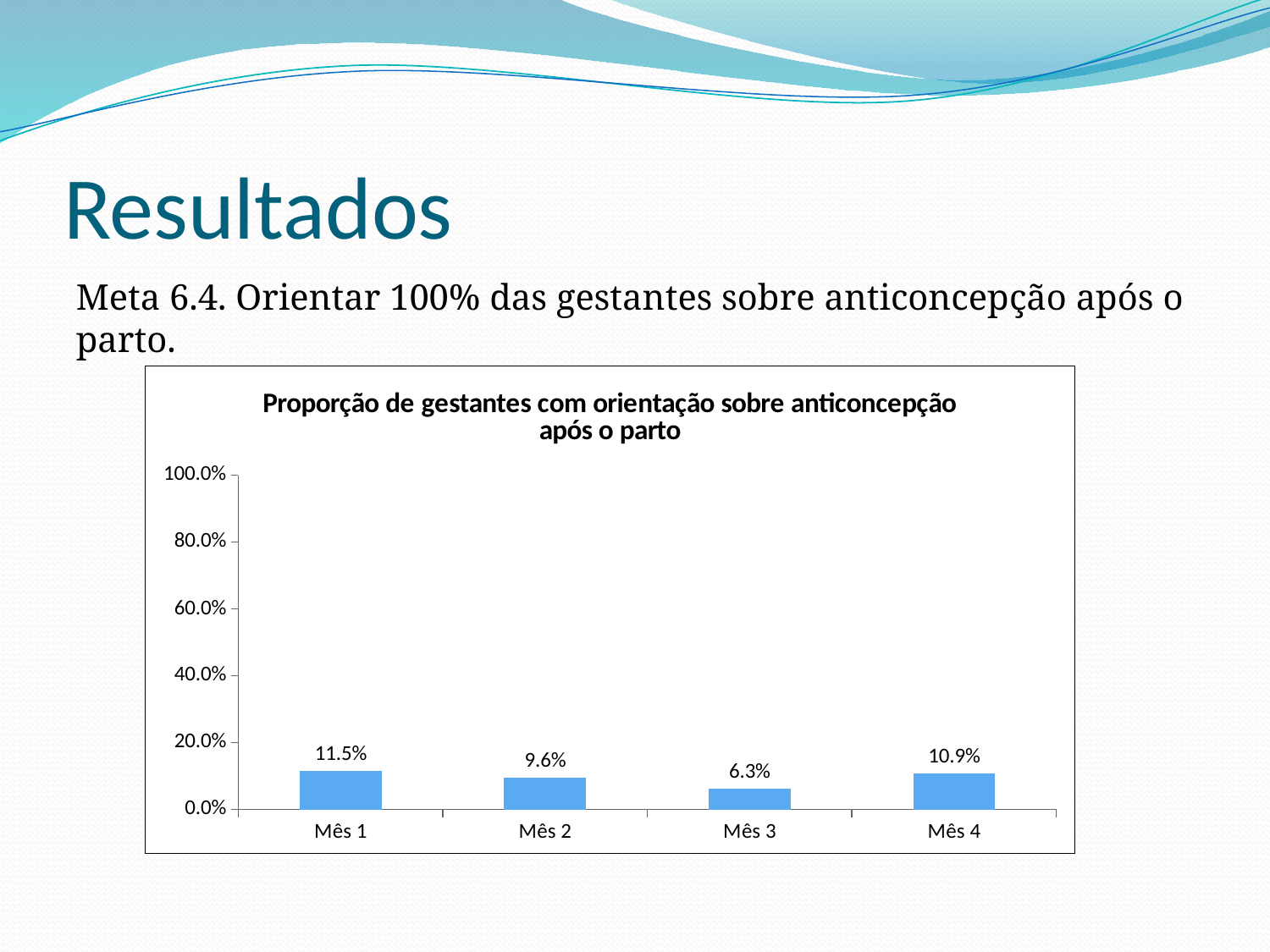
What kind of chart is shown on the slide? bar chart What is the value for Mês 3? 6.3% Which is larger, the value for Mês 2 or the value for Mês 3? Mês 2 What is the value for Mês 1? 11.5% How many months are shown on the x axis? 4 What is the difference between the values for Mês 4 and Mês 2? 1.3% What is the difference between the values for Mês 1 and Mês 3? 5.2% What is the value for Mês 4? 10.9% What is the title of the chart? Proporção de gestantes com orientação sobre anticoncepção após o parto Which month has the highest value? Mês 1 Which month has the lowest value? Mês 3 Is the value for Mês 1 greater or less than 20.0%? less